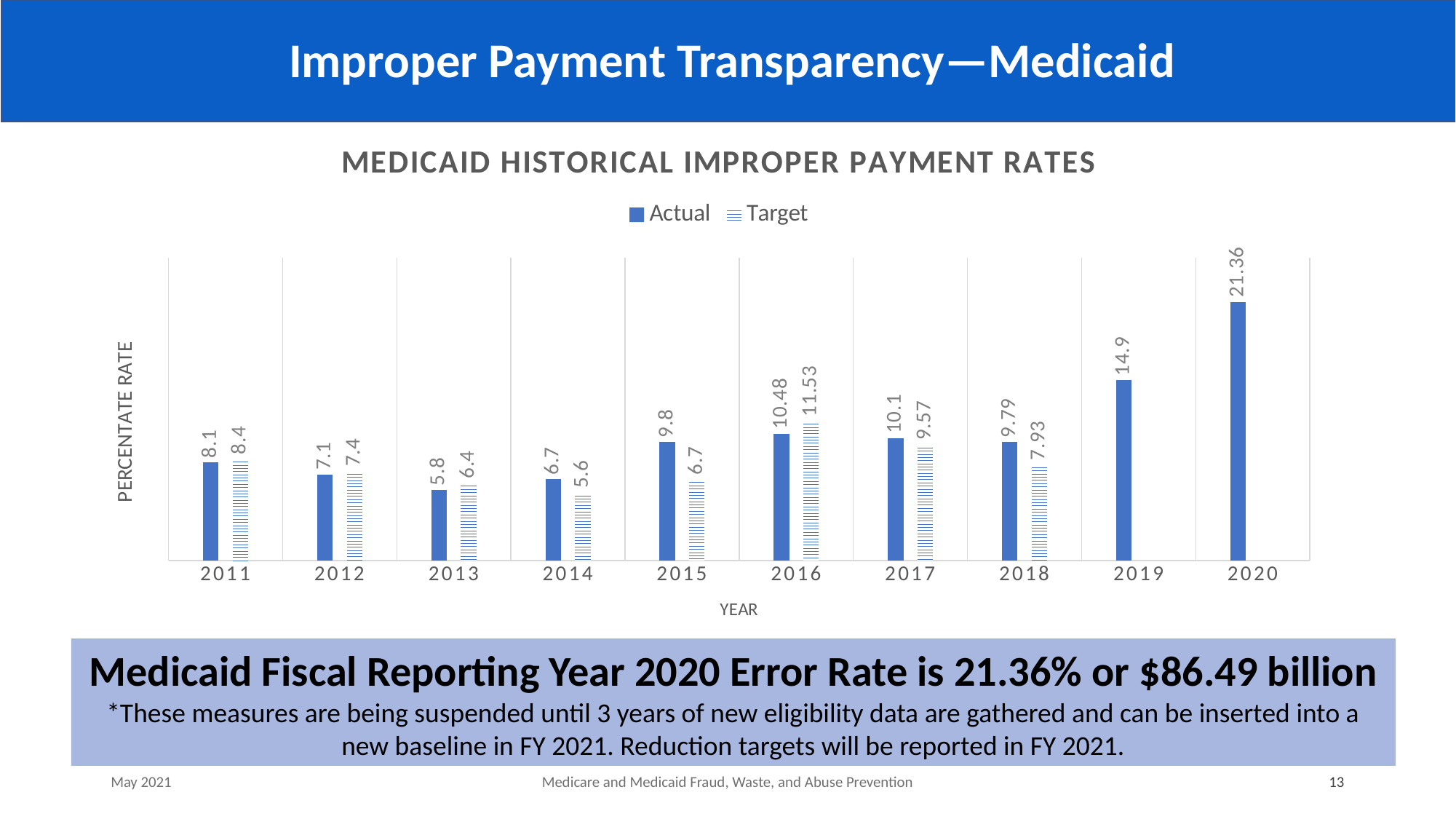
Which year has the lowest Actual improper payment rate? 2013 What kind of chart is shown on the slide? Bar chart What is the difference between the Actual rates for 2020 and 2019? 6.46 Which year has the highest Actual improper payment rate? 2020 Which is larger in 2014, the Actual rate or the Target rate? Actual How many years are shown on the x axis? 10 How many series does the legend list? 2 What is the Actual improper payment rate for 2020? 21.36 What is the Target improper payment rate for 2016? 11.53 Which is larger in 2016, the Actual rate or the Target rate? Target What is the Actual improper payment rate for 2013? 5.8 What is the title of the chart? MEDICAID HISTORICAL IMPROPER PAYMENT RATES